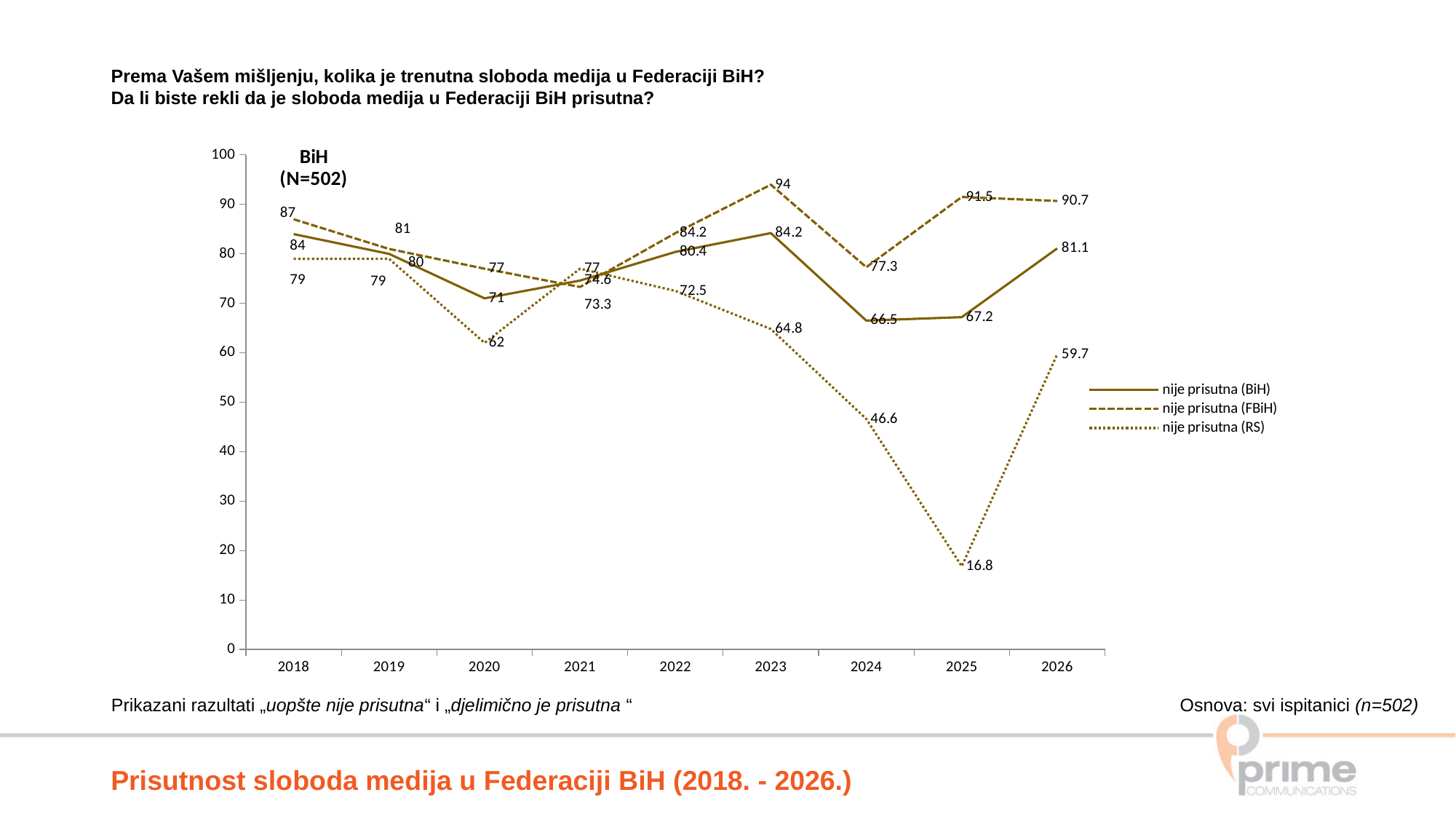
How many years are shown on the x axis? 9 What is the value for nije prisutna (BiH) in 2024? 66.5 How many series does the legend list? 3 What is the difference between nije prisutna (FBiH) and nije prisutna (RS) in 2025? 74.7 What type of chart is shown on the slide? line chart Which is larger in 2026: nije prisutna (BiH) or nije prisutna (RS)? nije prisutna (BiH) Does the nije prisutna (RS) series rise or fall from 2023 to 2025? fall What is the value for nije prisutna (FBiH) in 2023? 94 In which year is the nije prisutna (FBiH) series at its highest? 2023 In which year is the nije prisutna (RS) series at its lowest? 2025 What is the value for nije prisutna (RS) in 2025? 16.8 Which line style is used for the nije prisutna (FBiH) series? dashed